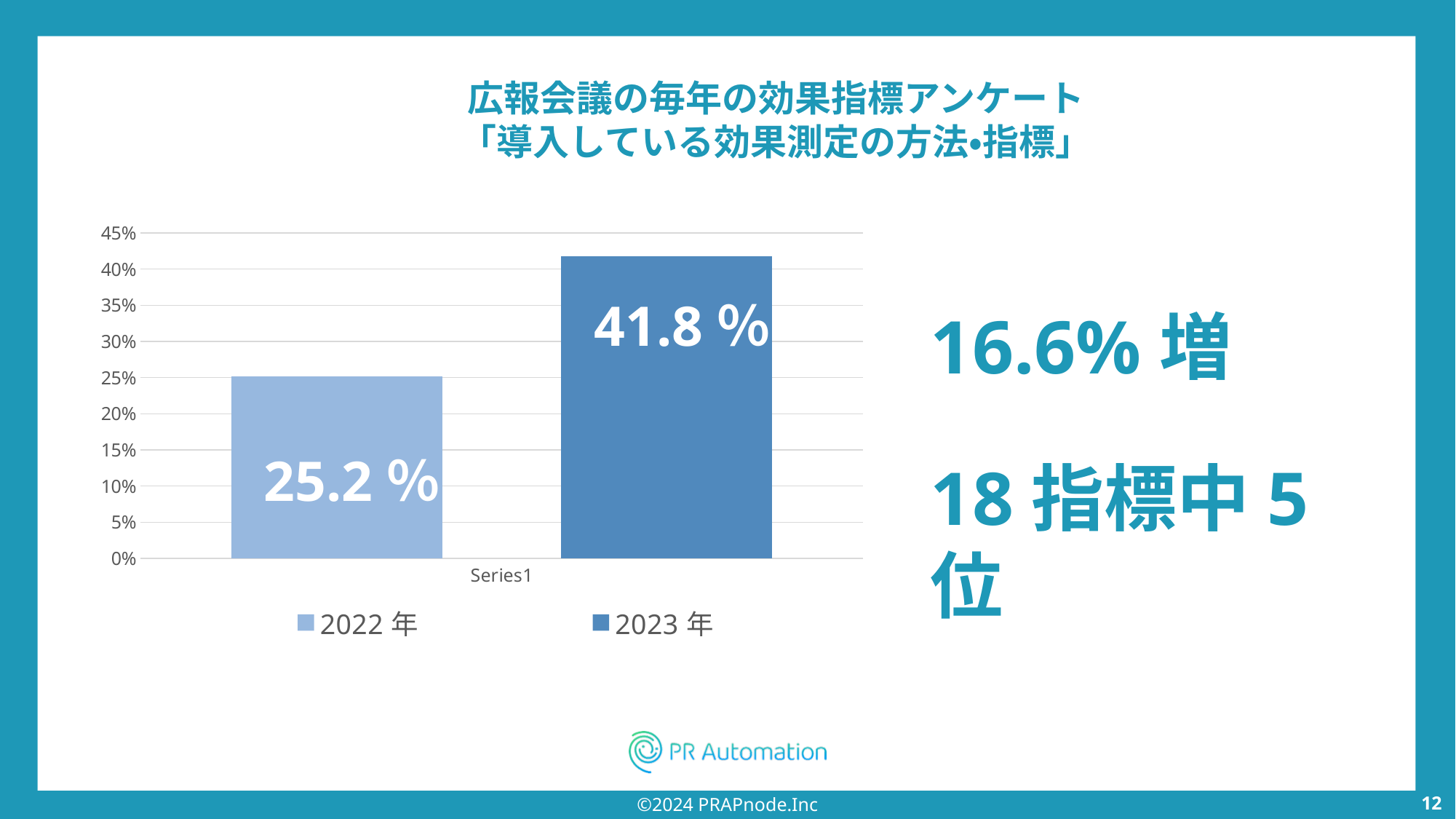
What is the label on the x axis under the bars? Series1 What is the value for 2022 年 in the chart? 25.2 % Which series has the highest value in the chart? 2023 年 Is the value for 2023 年 greater or less than 40%? greater What is the value for 2023 年 in the chart? 41.8 % How many bars are plotted in the chart? 2 How many series does the legend list? 2 Which series has the higher value, 2022 年 or 2023 年? 2023 年 What is the difference between the 2023 年 value and the 2022 年 value? 16.6% Is the value for 2022 年 greater or less than 30%? less What type of chart is shown on the slide? bar chart Which series has the lowest value in the chart? 2022 年